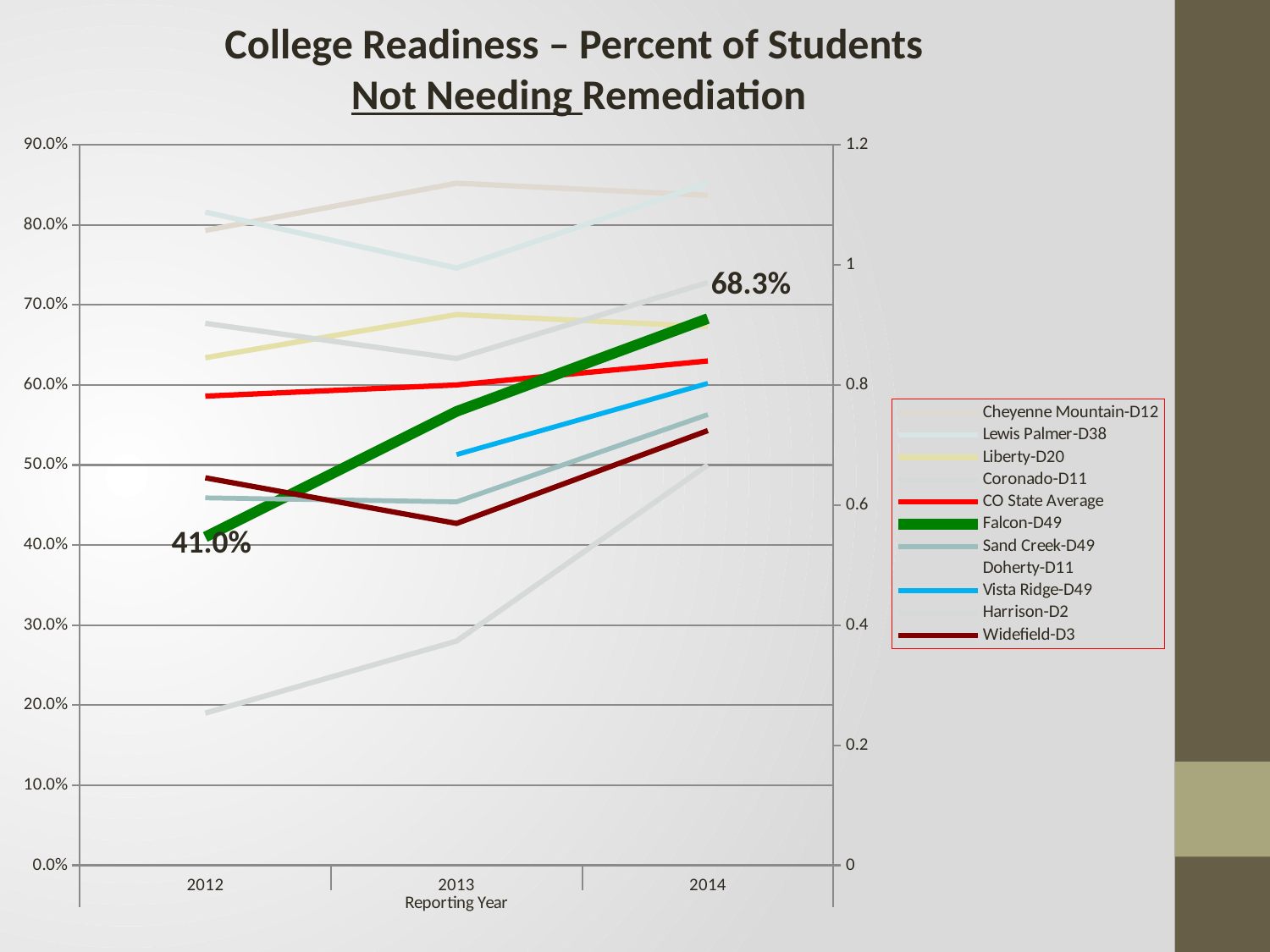
Does the CO State Average line rise or fall from 2012 to 2014? rise What is the value for Falcon-D49 in 2014? 68.3% What is the title of the x axis? Reporting Year What kind of chart is shown on the slide? line chart What is the value for Falcon-D49 in 2012? 41.0% By how many percentage points did Falcon-D49 increase from 2012 to 2014? 27.3 percentage points In 2014, which is higher: Falcon-D49 or CO State Average? Falcon-D49 Is the value for Widefield-D3 in 2013 greater or less than 50.0%? less Is the value for CO State Average in 2012 greater or less than 50.0%? greater How many series does the legend list? 11 How many reporting years are shown on the x axis? 3 Does the Falcon-D49 line rise or fall from 2012 to 2014? rise